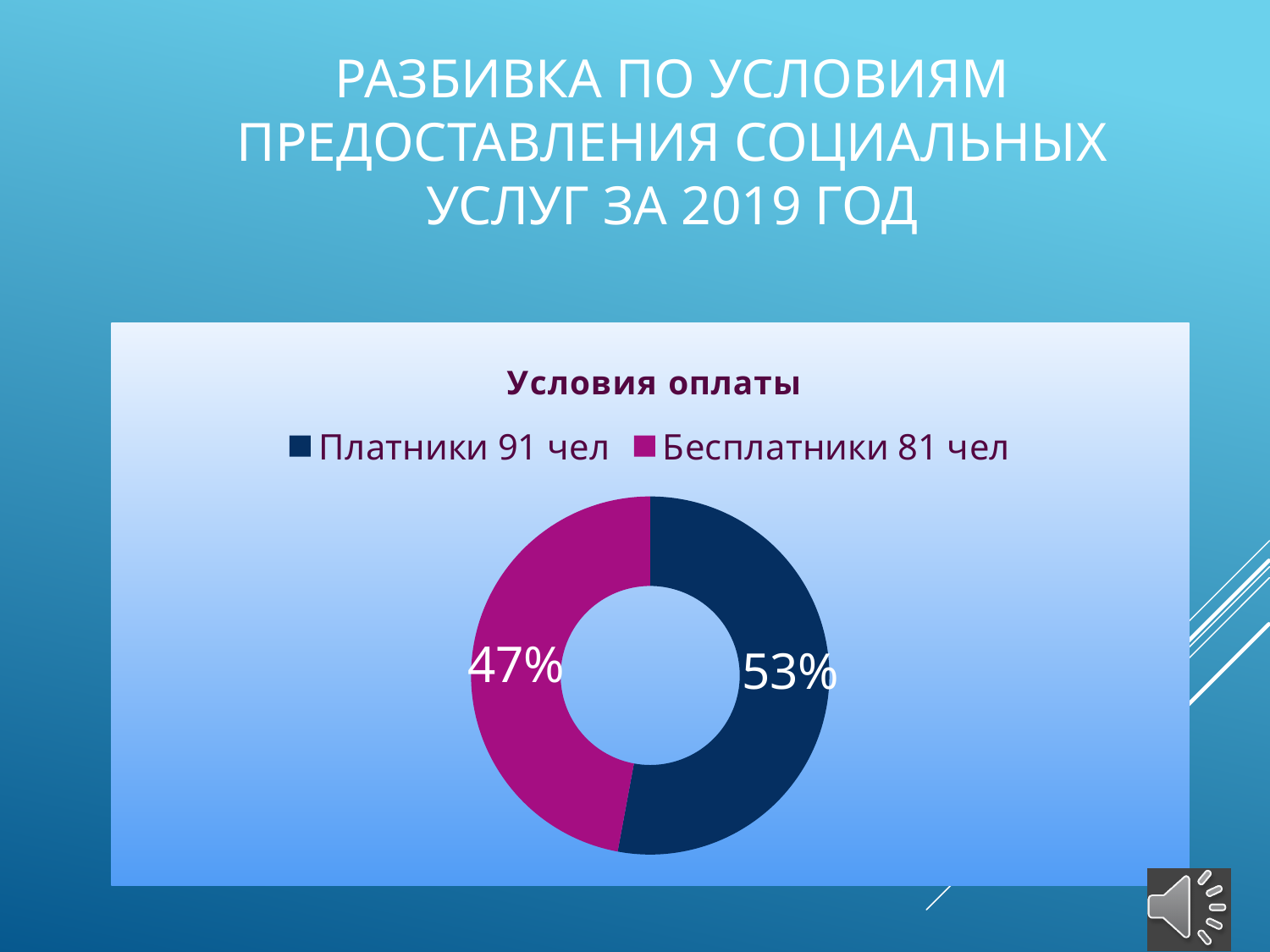
What is the title of the chart? Условия оплаты What kind of chart is shown on the slide? doughnut chart How many people are listed in the legend for Платники? 91 чел What percentage is shown for the Платники slice? 53% Which slice is the smallest? Бесплатники 81 чел What is the difference in percentage points between the Платники and Бесплатники slices? 6 How many entries does the legend list? 2 Which is larger, the Платники slice or the Бесплатники slice? Платники How many slices does the chart have? 2 What colour is the Бесплатники slice? magenta Which slice is the largest? Платники 91 чел What percentage is shown for the Бесплатники slice? 47%